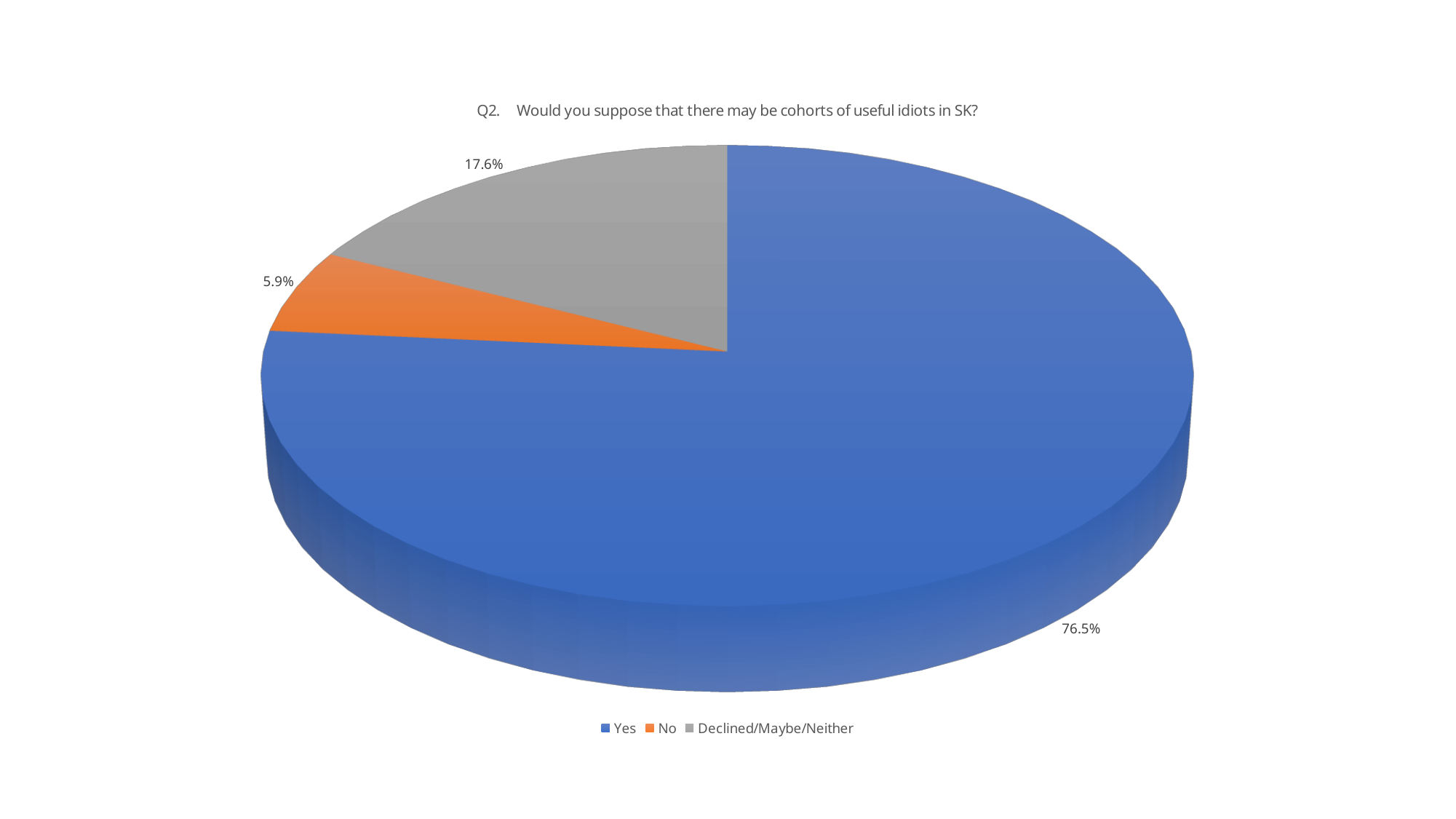
Which category has the smallest slice of the pie? No What is the difference in percentage points between the "Declined/Maybe/Neither" slice and the "No" slice? 11.7 Which is larger, the "No" slice or the "Declined/Maybe/Neither" slice? Declined/Maybe/Neither What is the title of the chart? Q2. Would you suppose that there may be cohorts of useful idiots in SK? What share of the pie does the "Yes" slice represent? 76.5% What share of the pie does the "Declined/Maybe/Neither" slice represent? 17.6% What share of the pie does the "No" slice represent? 5.9% What is the difference in percentage points between the "Yes" slice and the "Declined/Maybe/Neither" slice? 58.9 What kind of chart is shown on the slide? Pie chart What colour is the "No" slice in the pie chart? Orange Which category has the largest slice of the pie? Yes How many categories does the pie chart have? 3